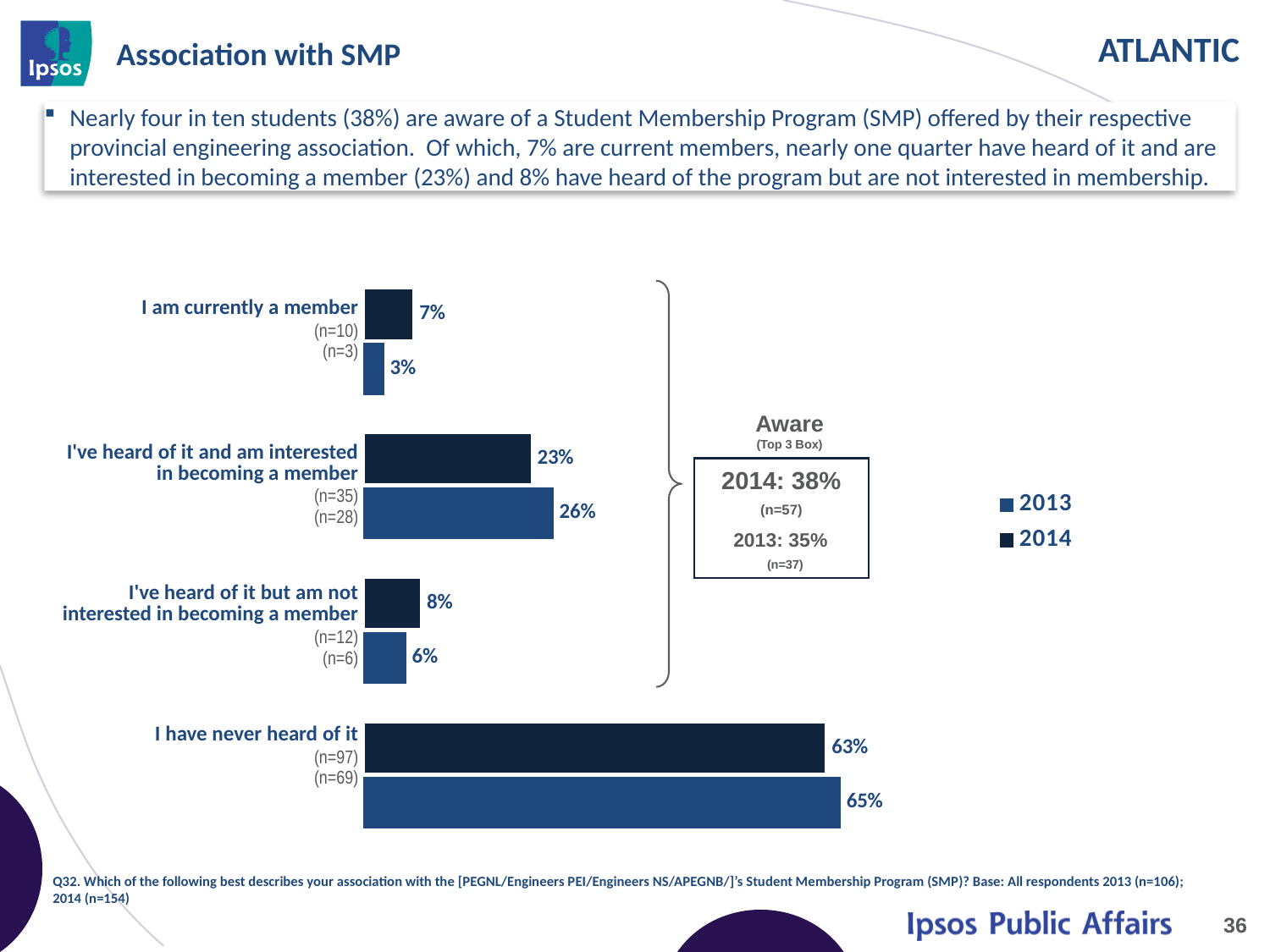
What type of chart is shown on the slide? Bar chart What value is shown on the upper bar for 'I am currently a member'? 7% What value is shown on the lower bar for 'I've heard of it but am not interested in becoming a member'? 6% What are the two entries listed in the chart legend? 2013 and 2014 What value is shown on the lower bar for 'I have never heard of it'? 65% Which response category has the shortest bar in the chart? I am currently a member Which response category has the longest bars in the chart? I have never heard of it How many response categories are plotted in the chart? 4 What is the difference between the two bars for 'I have never heard of it' (63% and 65%)? 2 percentage points How many series does the chart legend list? 2 What is the 2014 'Aware (Top 3 Box)' percentage shown in the box beside the chart? 38% For 'I've heard of it and am interested in becoming a member', which bar is larger, the upper bar or the lower bar? The lower bar (26%)